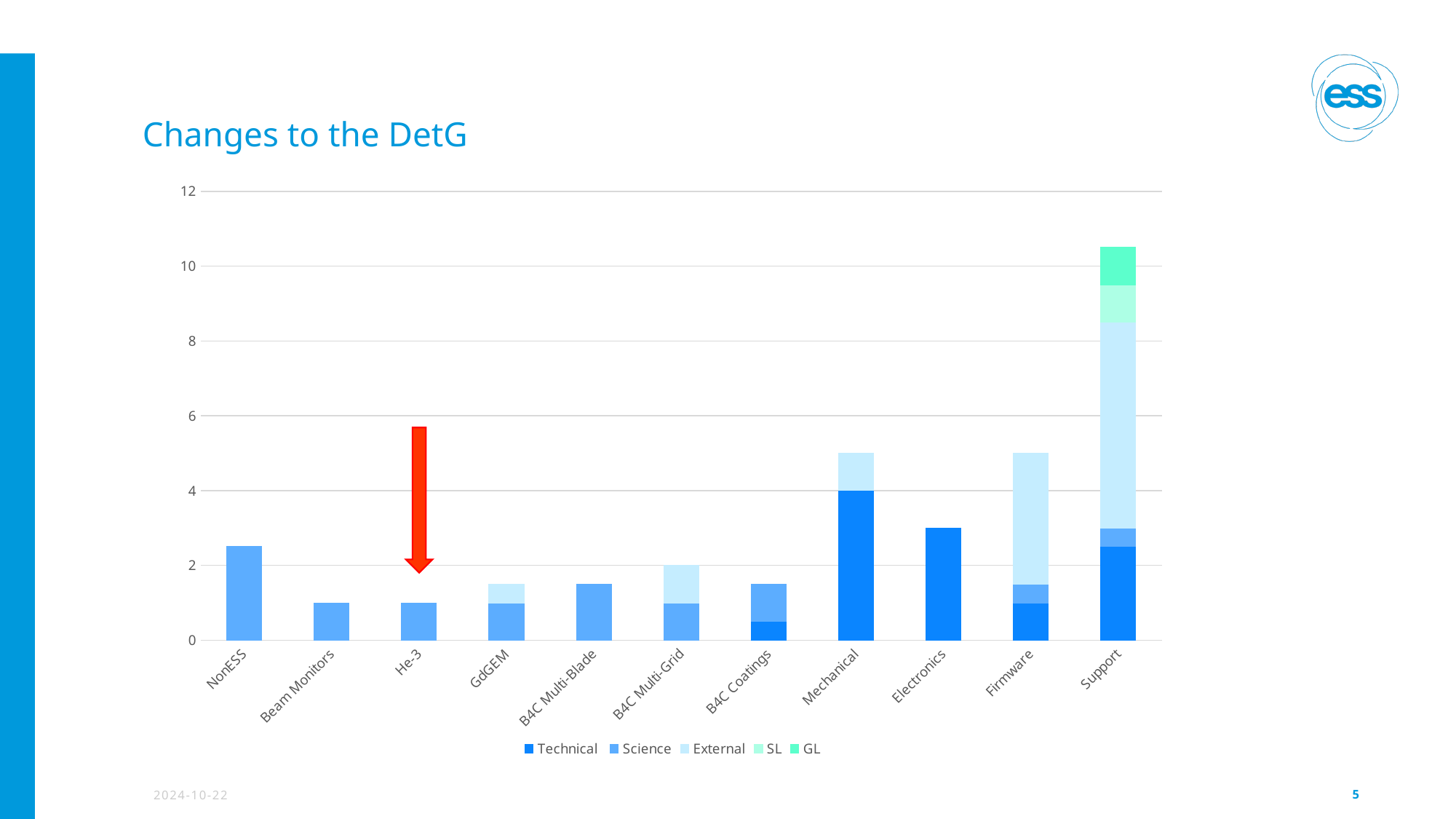
Which has the taller bar, Mechanical or Electronics? Mechanical Which category has the tallest stacked bar? Support What is the total height of the B4C Multi-Grid bar? 2 Which category does the red arrow point to? He-3 What kind of chart is shown on the slide? Stacked bar chart Is the total value for Support greater or less than 10? greater Is the total value for Electronics greater or less than 4? less How many categories are shown along the x axis? 11 Is the total value for Firmware greater or less than 4? greater What is the title of the slide containing the chart? Changes to the DetG What is the Technical value for Mechanical? 4 How many series does the legend list? 5